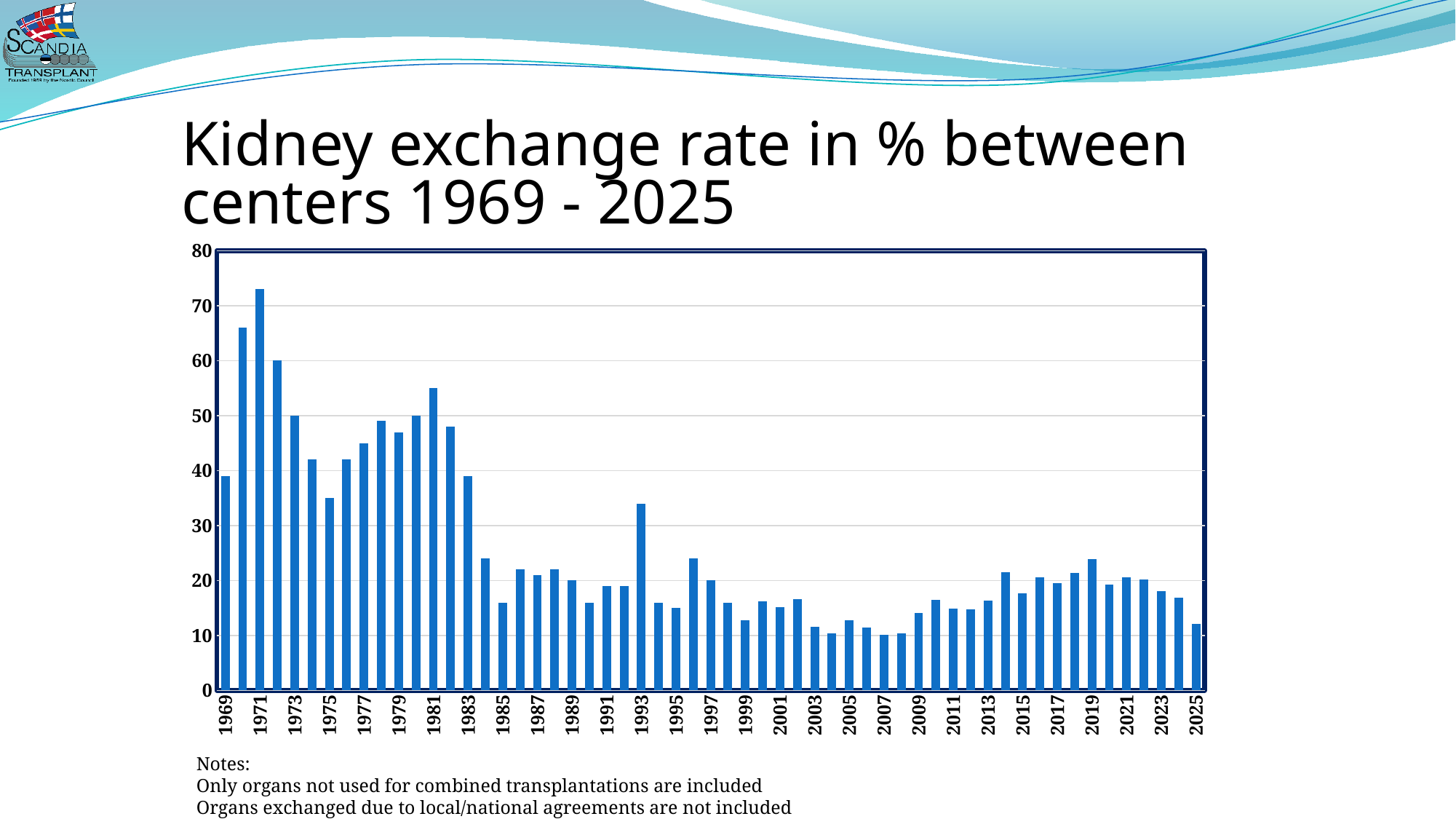
Is the value for 1975 greater or less than 40? less Is the value for 1985 greater or less than 20? less Which is larger, the value for 1993 or the value for 1995? 1993 Is the value for 1971 greater or less than 70? greater What is the highest value shown on the vertical axis? 80 Does the kidney exchange rate generally rise or fall from 1969 to 2025? fall Which is larger, the value for 1971 or the value for 1973? 1971 Which year has the highest kidney exchange rate? 1971 What kind of chart is shown on the slide? bar chart What is the title of the chart? Kidney exchange rate in % between centers 1969 - 2025